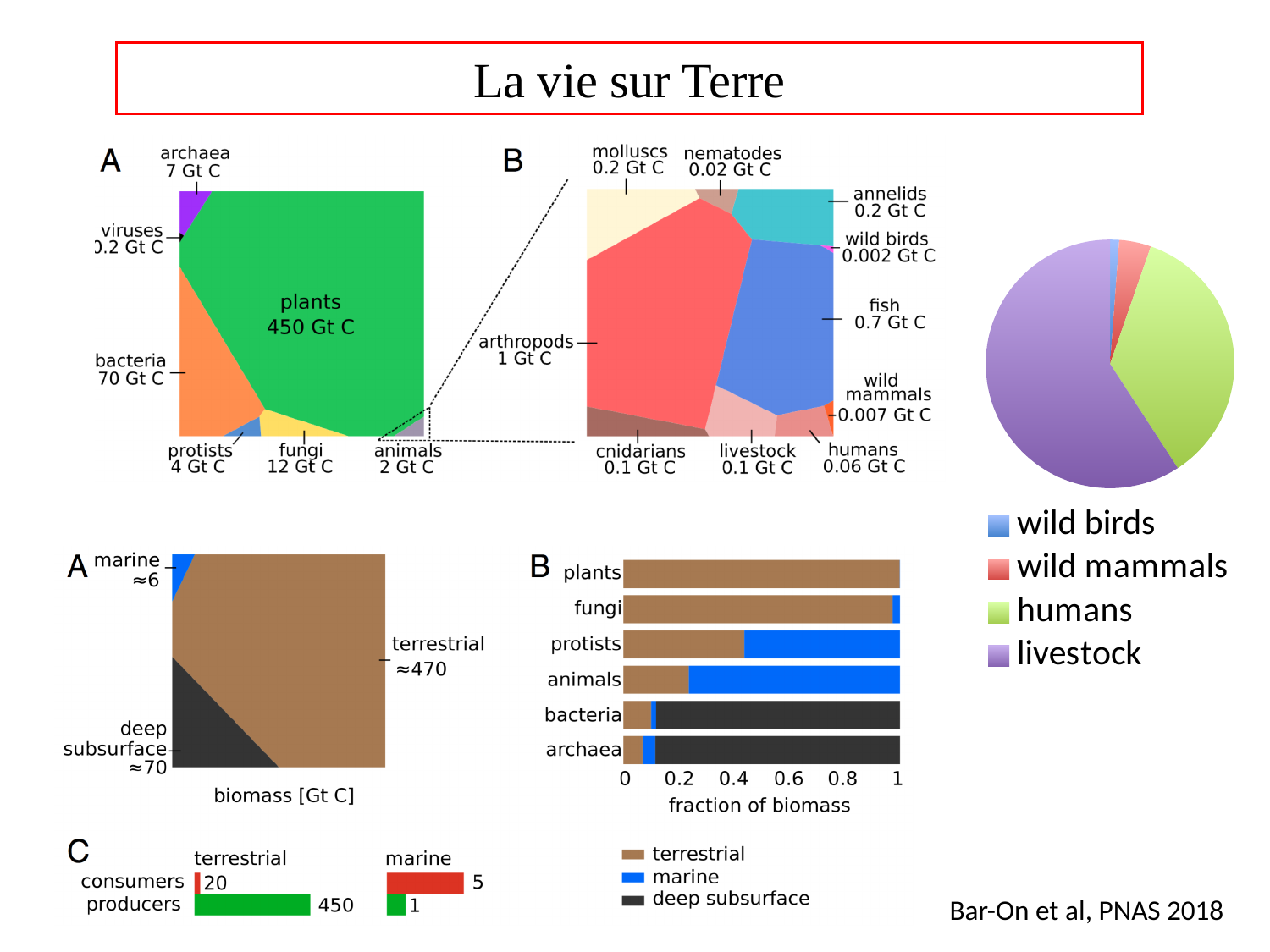
In the pie chart on the right, which category has the largest slice? livestock In the top-left treemap (panel A), what is the biomass of plants? 450 Gt C In the bottom-left bar chart (panel C), what is the value for terrestrial producers? 450 In the bottom-left bar chart (panel C), what is the difference between marine consumers and marine producers? 4 In the top-left treemap (panel A), what is the biomass of bacteria? 70 Gt C In the top-middle treemap (panel B), which is larger, the biomass of arthropods or of fish? arthropods In the pie chart on the right, which category has the smallest slice? wild birds In the 'fraction of biomass' stacked bar chart (panel B, bottom middle), how many categories are shown on the y axis? 6 In the 'fraction of biomass' stacked bar chart (panel B, bottom middle), is the terrestrial fraction for animals greater or less than 0.4? less In the top-left treemap (panel A), what is the difference in biomass between fungi and protists? 8 Gt C How many entries does the legend of the pie chart on the right list? 4 In the top-middle treemap (panel B), what is the biomass of fish? 0.7 Gt C